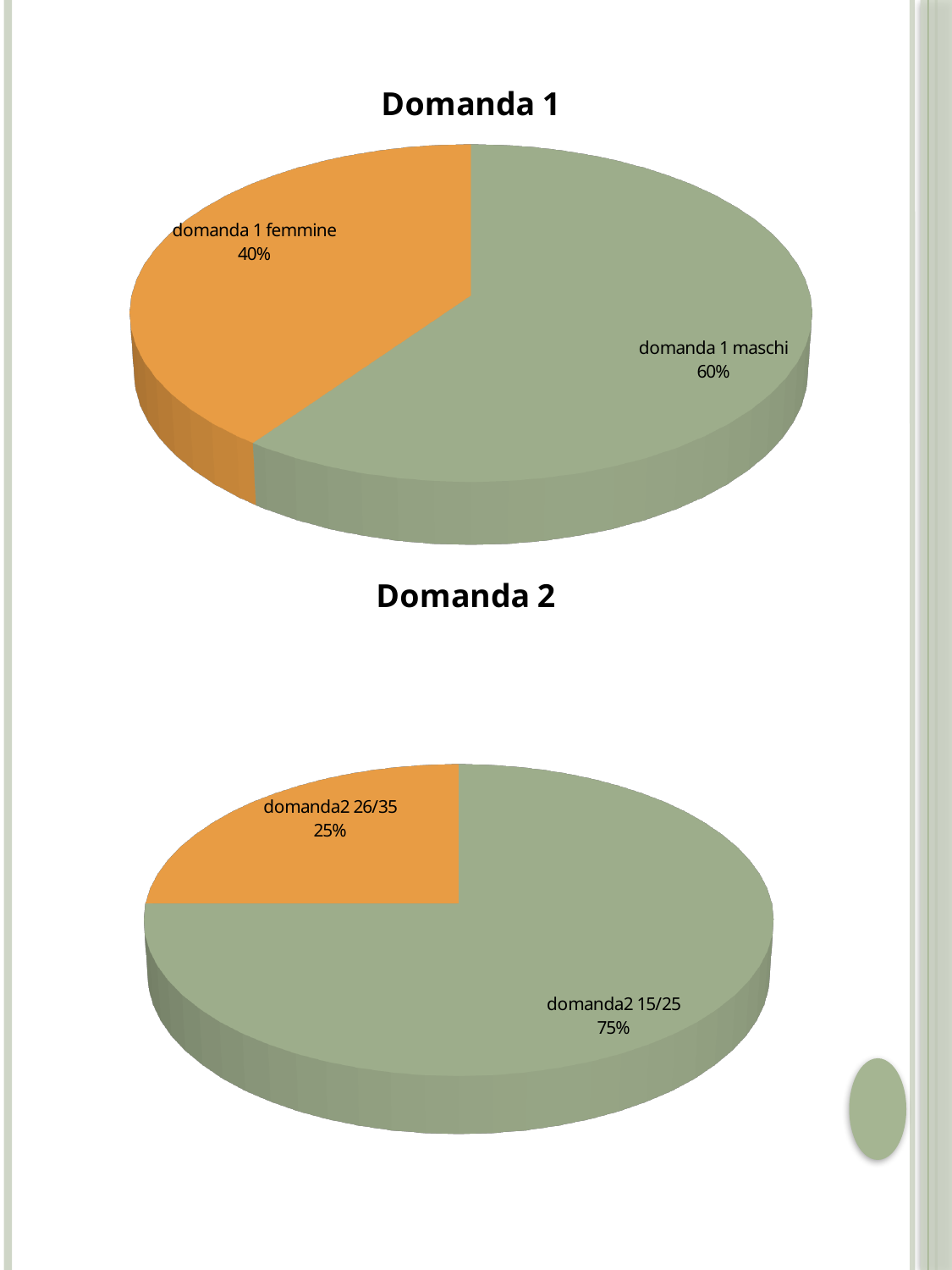
In the 'Domanda 2' chart, what share does 'domanda2 26/35' have? 25% In the 'Domanda 2' chart, what colour is the 'domanda2 26/35' slice? orange In the 'Domanda 1' chart, how many slices does the pie have? 2 In the 'Domanda 2' chart, which is larger, 'domanda2 15/25' or 'domanda2 26/35'? domanda2 15/25 In the 'Domanda 2' chart, what is the difference in percentage points between 'domanda2 15/25' and 'domanda2 26/35'? 50 In the 'Domanda 2' chart, which slice is the smallest? domanda2 26/35 In the 'Domanda 1' chart, what share does 'domanda 1 maschi' have? 60% In the 'Domanda 2' chart, what share does 'domanda2 15/25' have? 75% In the 'Domanda 1' chart, what is the difference in percentage points between 'domanda 1 maschi' and 'domanda 1 femmine'? 20 In the 'Domanda 1' chart, which slice is the largest? domanda 1 maschi What kind of chart is 'Domanda 1'? pie chart